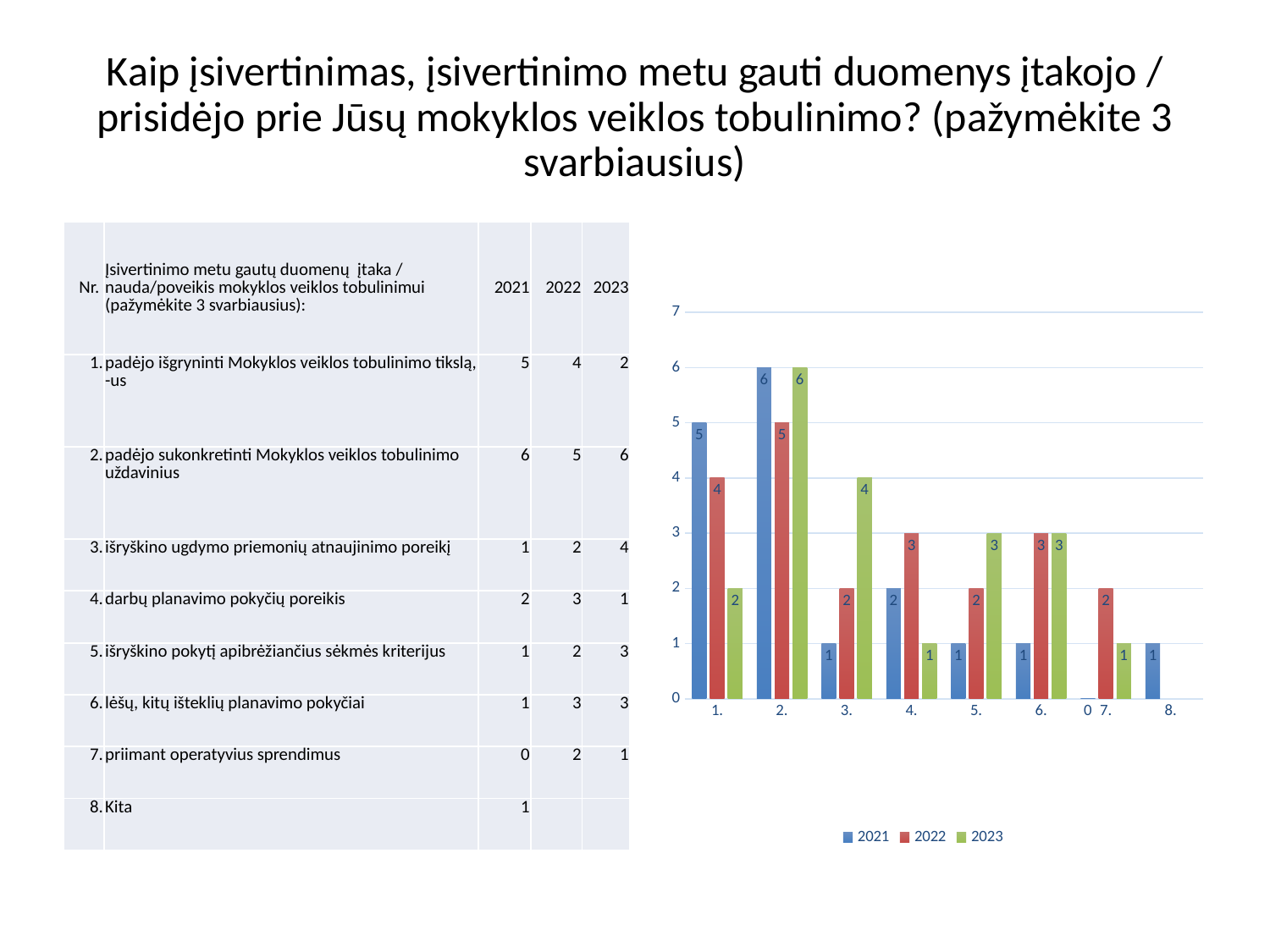
How many series does the legend of the bar chart list? 3 In the bar chart, what is the value for 2023 in category 3.? 4 In the bar chart, which category has the highest value for the 2023 series? 2. In the bar chart, what is the value for 2021 in category 2.? 6 How many categories are shown on the x axis of the bar chart? 8 In the bar chart, which category has the lowest value for the 2021 series? 7. In the bar chart, which category has the highest value for the 2021 series? 2. In the bar chart, in category 4., which series has the larger value, 2022 or 2023? 2022 What kind of chart is shown on the slide? bar chart In the bar chart, what is the difference between the 2021 and 2023 values in category 1.? 3 In the bar chart, what is the value for 2022 in category 6.? 3 What are the entries in the legend of the bar chart? 2021, 2022, 2023